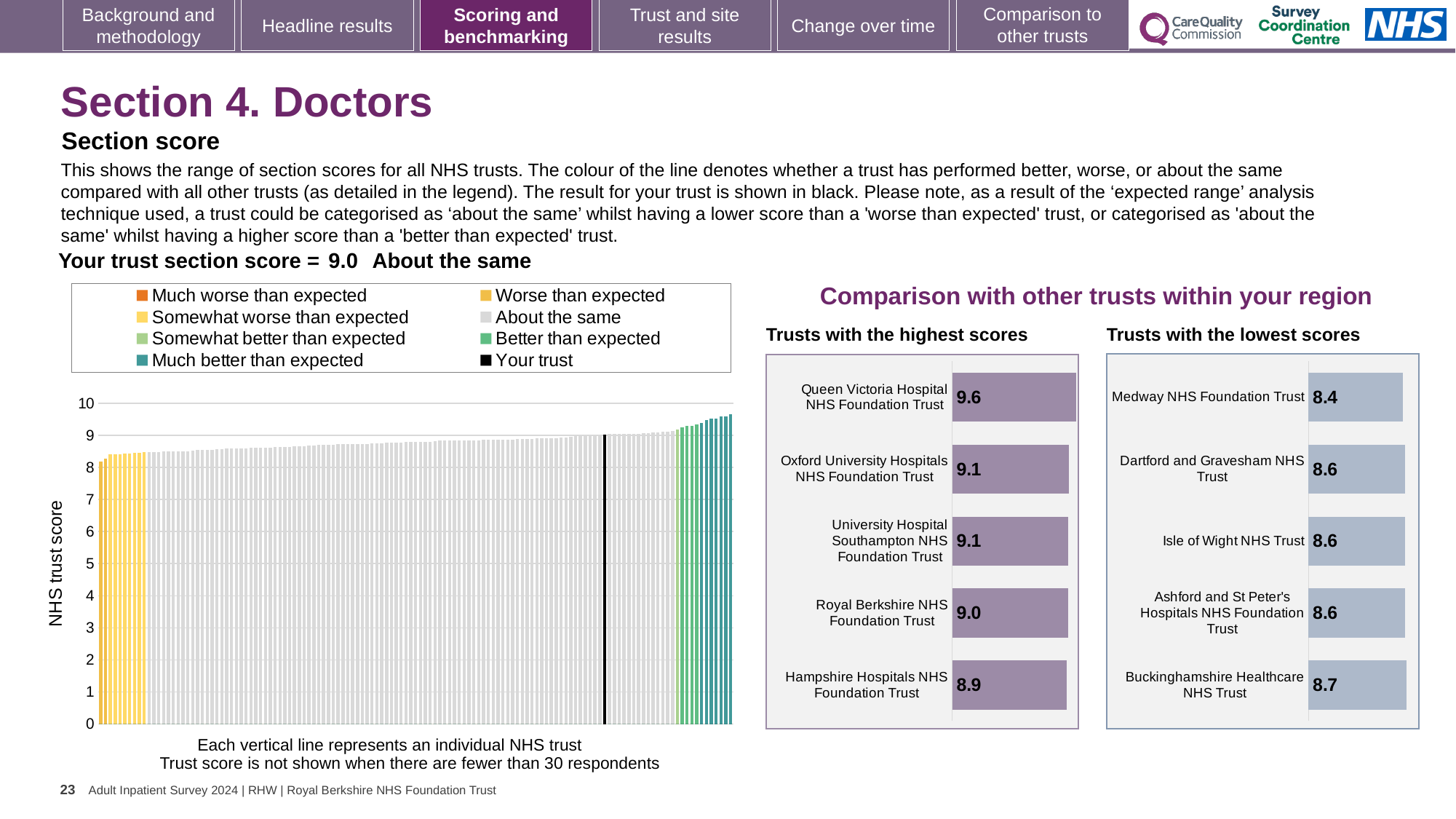
In the 'Trusts with the lowest scores' chart, what is the difference between the scores of Buckinghamshire Healthcare NHS Trust and Medway NHS Foundation Trust? 0.3 In the 'Trusts with the highest scores' chart, how many trusts are listed? 5 In the 'Trusts with the highest scores' chart, what is the difference between the scores of Queen Victoria Hospital NHS Foundation Trust and Hampshire Hospitals NHS Foundation Trust? 0.7 What kind of chart is the large chart on the left showing NHS trust scores? Bar chart In the 'Trusts with the lowest scores' chart, which has a higher score: Medway NHS Foundation Trust or Isle of Wight NHS Trust? Isle of Wight NHS Trust In the 'Trusts with the lowest scores' chart, which trust has the highest score? Buckinghamshire Healthcare NHS Trust In the 'Trusts with the highest scores' chart, what is the score for Hampshire Hospitals NHS Foundation Trust? 8.9 How many entries does the legend of the large chart on the left list? 8 In the 'Trusts with the highest scores' chart, what is the score for Queen Victoria Hospital NHS Foundation Trust? 9.6 In the 'Trusts with the lowest scores' chart, which trust has the lowest score? Medway NHS Foundation Trust In the 'Trusts with the lowest scores' chart, what is the score for Medway NHS Foundation Trust? 8.4 In the 'Trusts with the highest scores' chart, which trust has the highest score? Queen Victoria Hospital NHS Foundation Trust